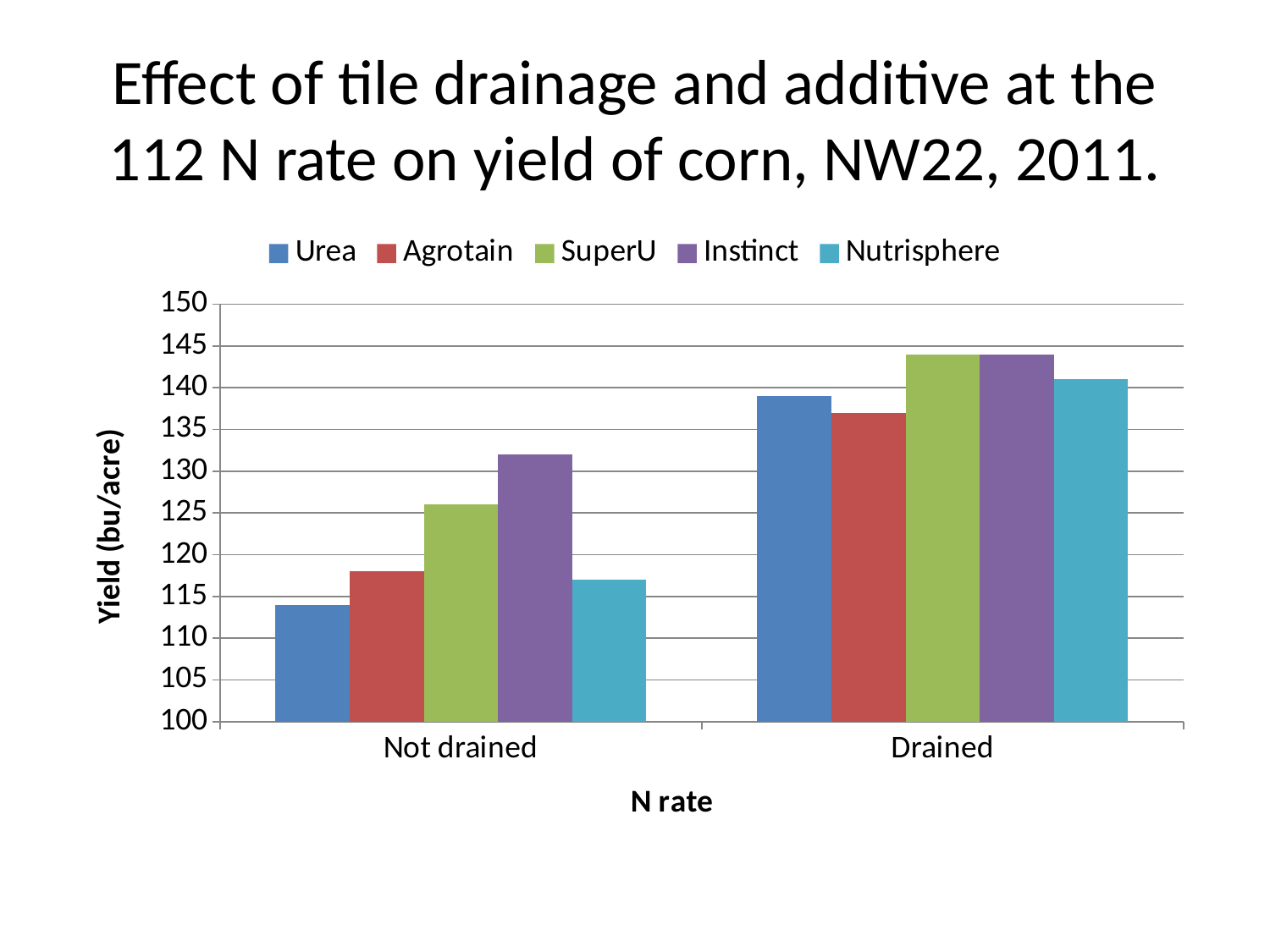
How many categories are shown on the x axis? 2 Is the yield for Agrotain in the Drained category greater or less than 140? less Which additive has the lowest yield in the Not drained category? Urea What kind of chart is shown on the slide? bar chart Which is larger in the Not drained category, the yield for SuperU or for Nutrisphere? SuperU Is the yield for SuperU in the Drained category greater or less than 140? greater Is the yield for Urea in the Not drained category greater or less than 120? less Which is larger, the Instinct yield for Not drained or the Instinct yield for Drained? Drained What is the label of the y axis? Yield (bu/acre) Which additive has the highest yield in the Not drained category? Instinct How many series does the legend list? 5